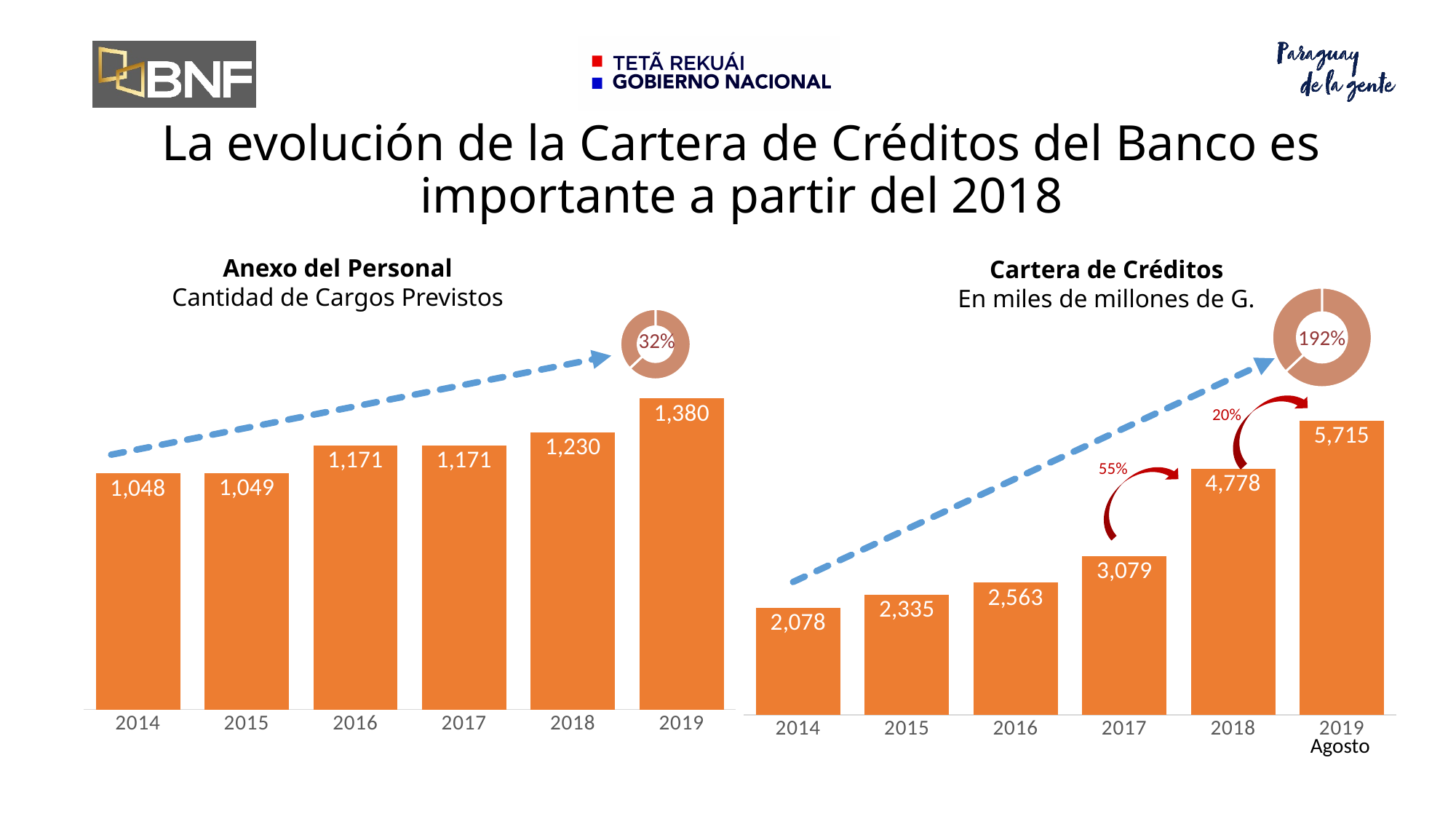
In the 'Anexo del Personal' chart, what is the value for 2019? 1,380 In the 'Cartera de Créditos' chart, what is the value for 2017? 3,079 How many years are shown on the x axis of the 'Cartera de Créditos' chart? 6 What percentage is shown in the circle above the 'Cartera de Créditos' chart? 192% What type of chart is the 'Anexo del Personal' chart? bar chart In the 'Cartera de Créditos' chart, what is the value for 2019? 5,715 In the 'Cartera de Créditos' chart, what is the difference between the 2019 and 2018 values? 937 In the 'Anexo del Personal' chart, which year has the highest value? 2019 In the 'Cartera de Créditos' chart, which year has the lowest value? 2014 In the 'Anexo del Personal' chart, what is the value for 2014? 1,048 In the 'Cartera de Créditos' chart, which is larger: the value for 2016 or the value for 2017? 2017 In the 'Anexo del Personal' chart, what is the difference between the 2019 and 2014 values? 332